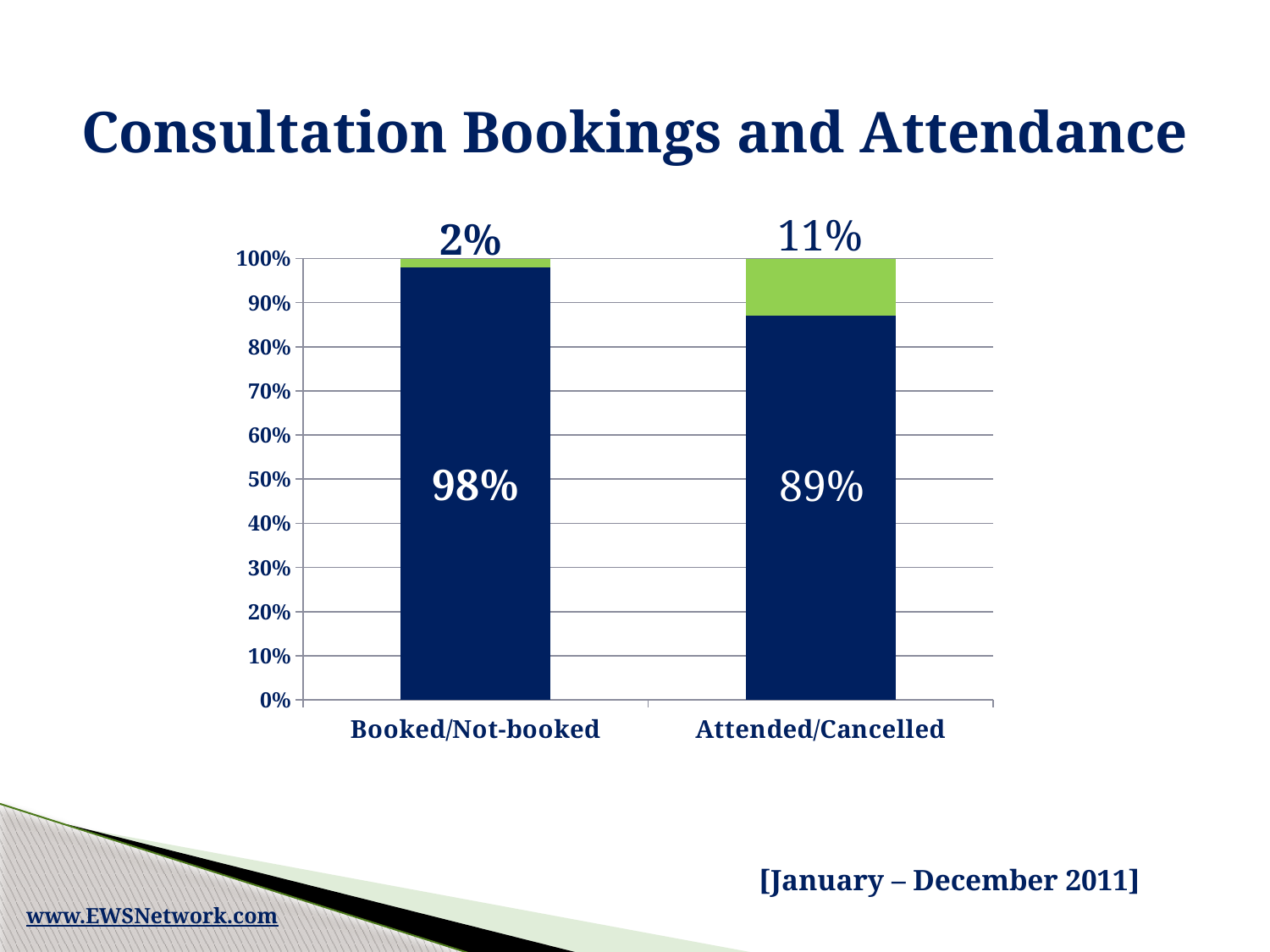
What is the total of the two segments in the Attended/Cancelled bar? 100% What value is shown on the dark blue segment of the Booked/Not-booked bar? 98% Which bar has the larger green segment, Booked/Not-booked or Attended/Cancelled? Attended/Cancelled What value is shown on the green segment of the Attended/Cancelled bar? 11% What is the title of the chart on the slide? Consultation Bookings and Attendance What value is shown on the green segment of the Booked/Not-booked bar? 2% What is the difference between the dark blue segment values of the Booked/Not-booked bar and the Attended/Cancelled bar? 9% What kind of chart is shown on the slide? Stacked bar chart What is the difference between the green segment values of the Attended/Cancelled bar and the Booked/Not-booked bar? 9% How many categories are shown on the x axis of the chart? 2 What value is shown on the dark blue segment of the Attended/Cancelled bar? 89% Which bar has the larger dark blue segment, Booked/Not-booked or Attended/Cancelled? Booked/Not-booked